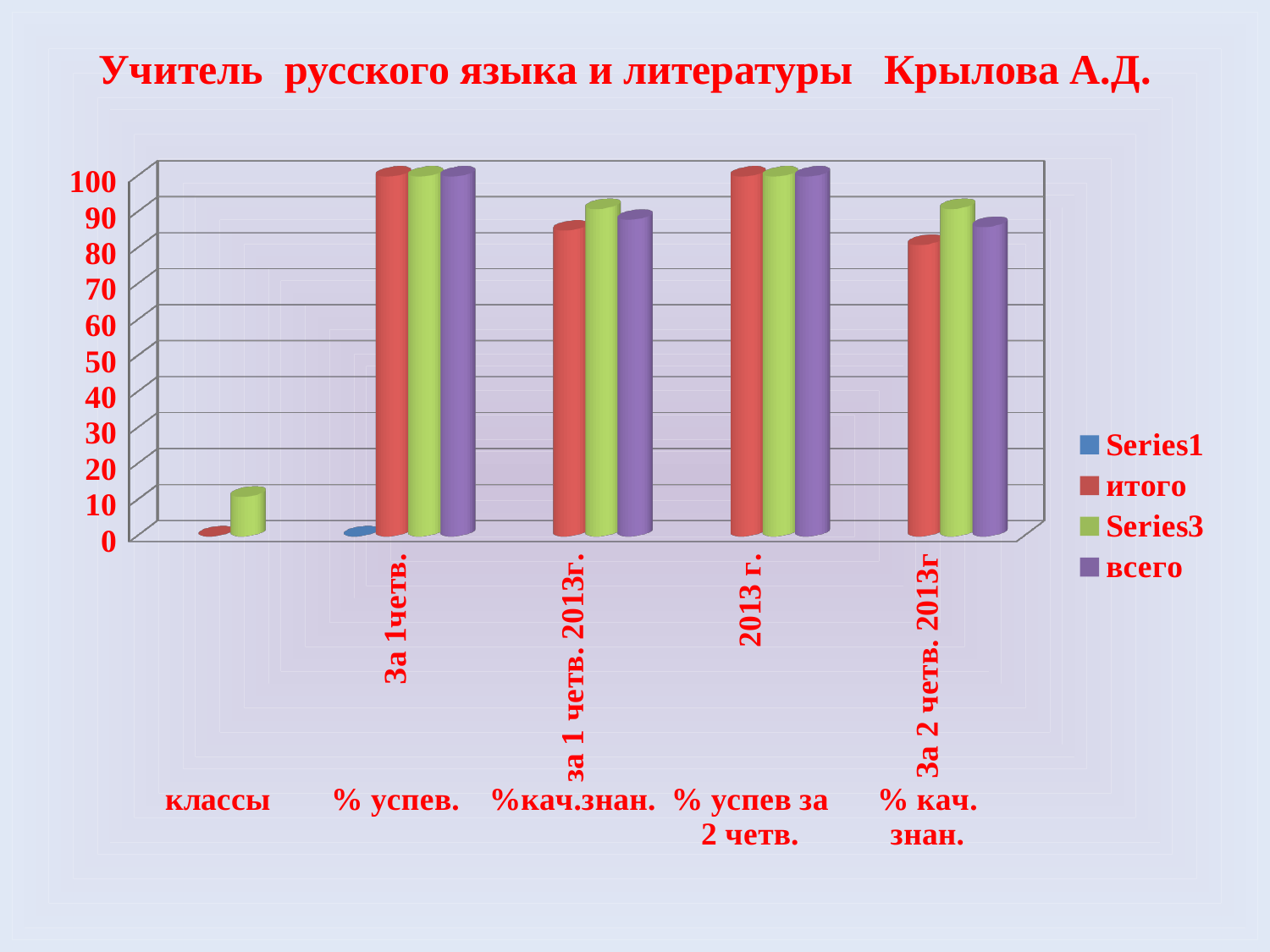
How many categories are shown along the x axis? 5 How many series does the legend list? 4 What is the value for всего in the % успев за 2 четв. category? 100 Is the value for итого in the %кач.знан. category greater or less than 80? greater What is the name of the second series listed in the legend? итого Is the value for итого in the % кач. знан. category greater or less than 90? less Is the value for Series3 in the классы category greater or less than 20? less In the % кач. знан. category, which is larger: Series3 or всего? Series3 Which series has the lowest value in the % кач. знан. category? итого Which series has the highest value in the %кач.знан. category? Series3 What kind of chart is shown on the slide? bar chart What is the value for итого in the % успев. category? 100